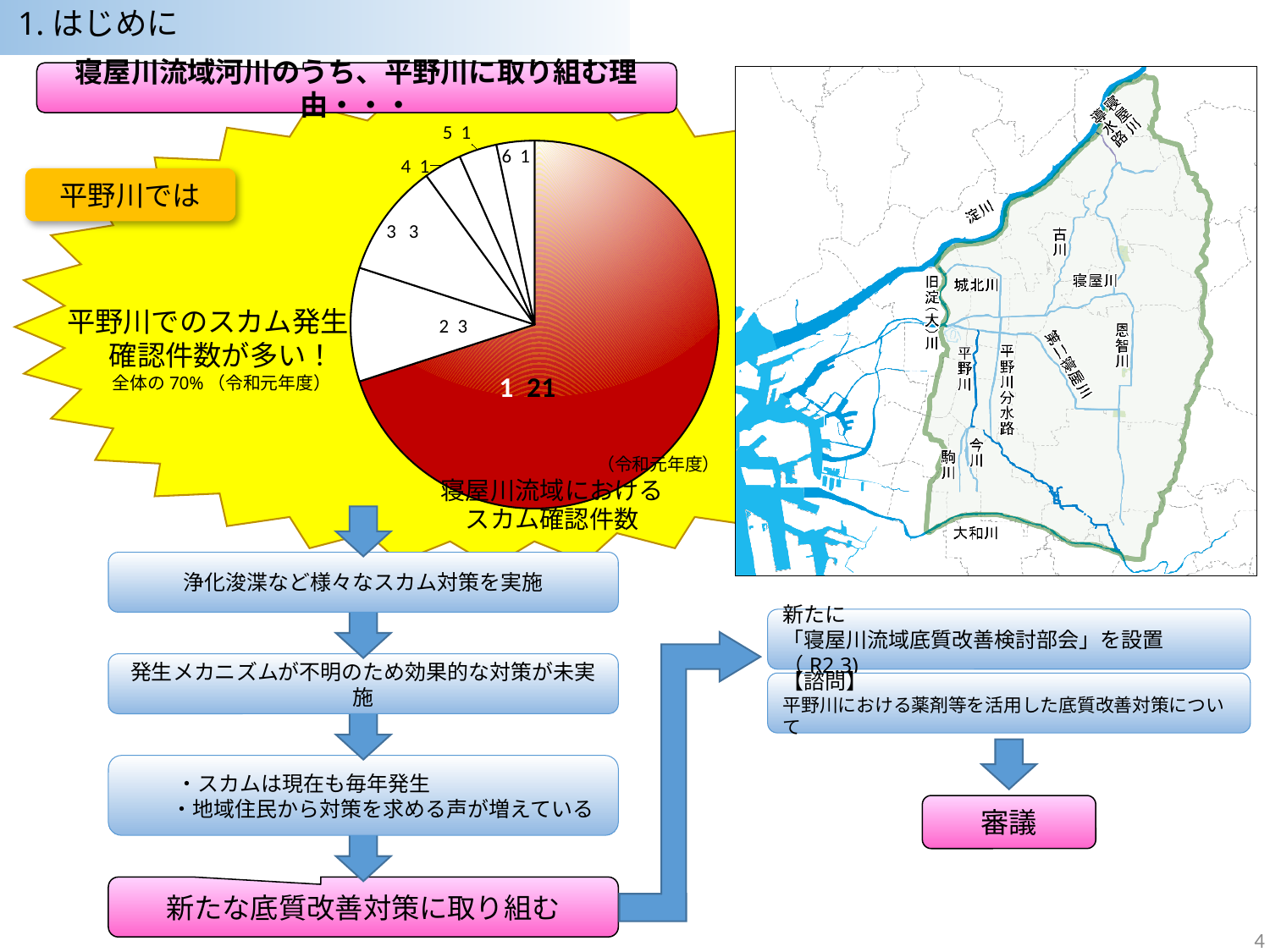
In the pie chart, what is the value for category 1? 21 How many slices in the pie chart have a value of 1? 3 In the pie chart, what is the value for category 6? 1 What is the total of all slice values in the pie chart? 30 What share of the pie does category 1 represent? 70% What kind of chart is used to show 寝屋川流域におけるスカム確認件数? pie chart In the pie chart, which is larger, the value for category 2 or category 4? category 2 Which category has the largest slice in the pie chart? 1 Which fiscal year does the pie chart 寝屋川流域におけるスカム確認件数 refer to? 令和元年度 How many slices does the pie chart 寝屋川流域におけるスカム確認件数 have? 6 What is the difference between the values for category 1 and category 2 in the pie chart? 18 In the pie chart, what is the value for category 2? 3